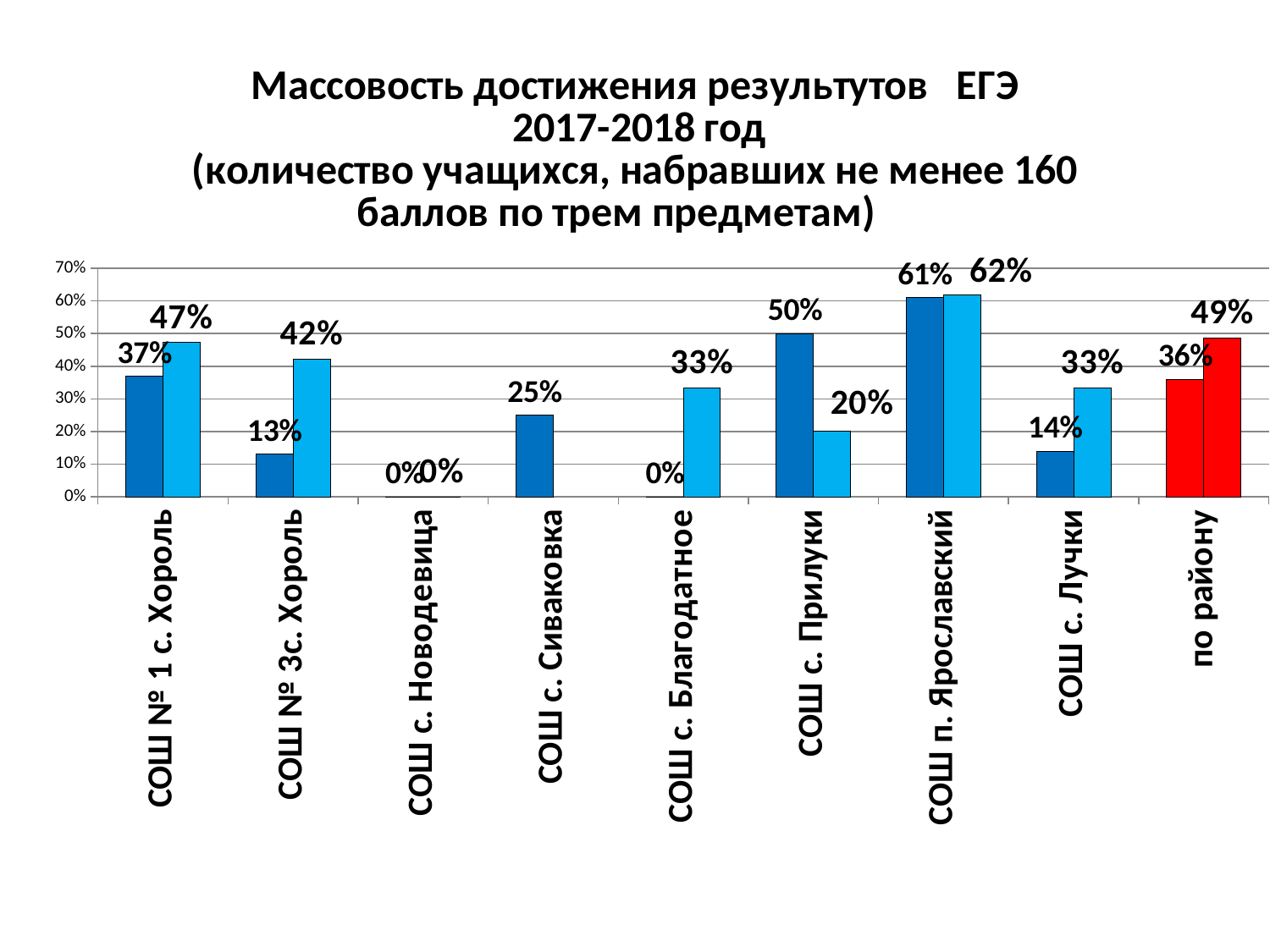
What colour are the bars for the по району category? red Which category has the highest value among the second (light-coloured) bars? СОШ п. Ярославский What kind of chart is shown on the slide? bar chart What is the value of the second (light blue) bar for СОШ с. Прилуки? 20% How many categories are shown on the x axis of the chart? 9 Which is larger for СОШ с. Лучки: the first (dark blue) bar or the second (light blue) bar? the second (light blue) bar What is the difference between the first bar (50%) and the second bar (20%) for СОШ с. Прилуки? 30% What is the difference between the second bar (47%) and the first bar (37%) for СОШ № 1 с. Хороль? 10% What is the value of the second (light blue) bar for СОШ № 3с. Хороль? 42% What is the value of the first (dark blue) bar for СОШ № 1 с. Хороль? 37% What is the value of the second (red) bar for по району? 49% Which category has the highest value among the first (dark blue) bars? СОШ п. Ярославский